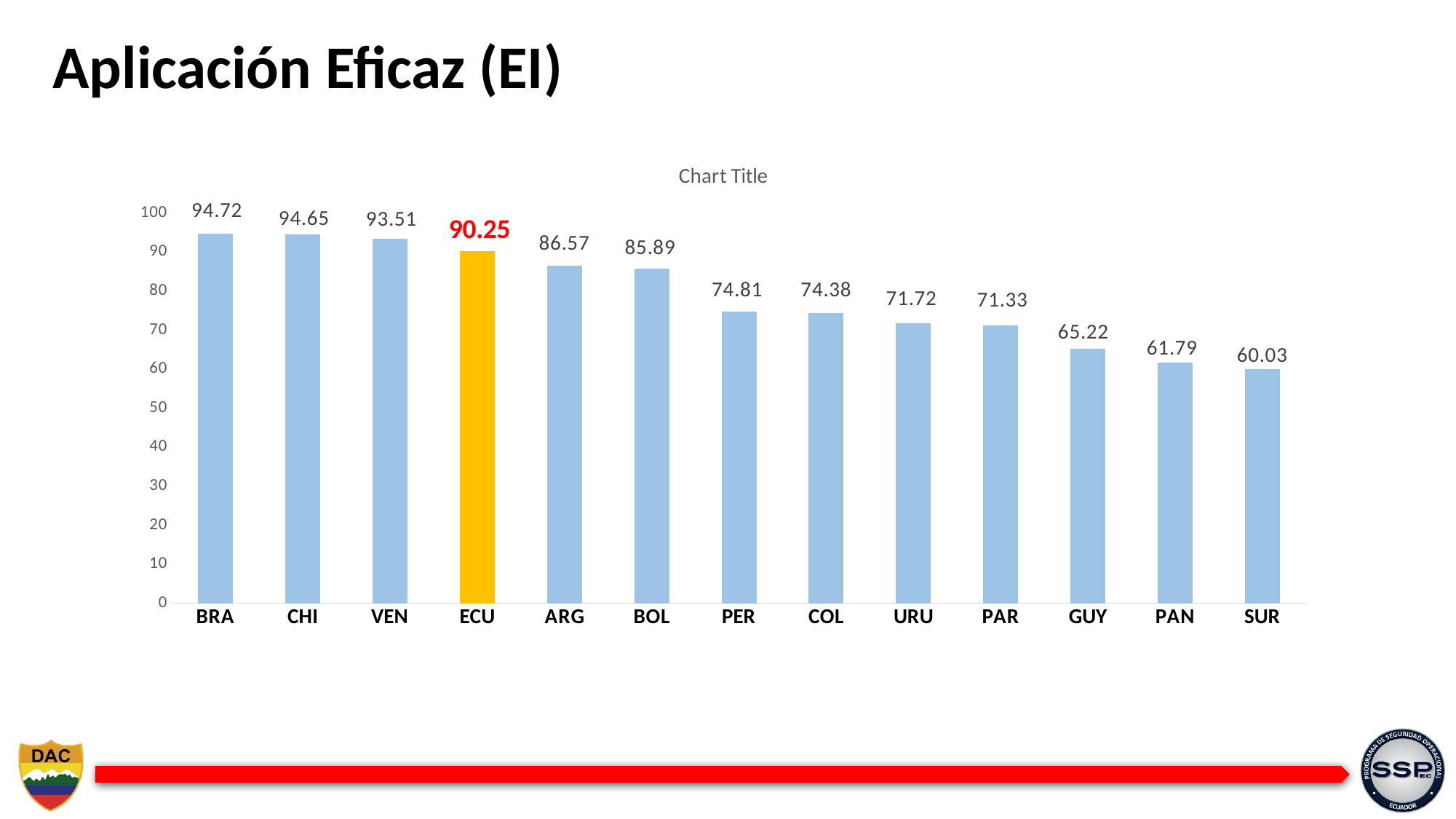
Is the value for URU greater or less than 70? greater What is the value for SUR? 60.03 Which bar is highlighted in a different colour (orange) from the others? ECU What is the value for PER? 74.81 Which is larger, the value for ARG or the value for BOL? ARG Which country has the lowest value? SUR Which country has the highest value? BRA What kind of chart is shown on the slide? Bar chart What is the difference between the values for GUY and PAN? 3.43 What is the value for ECU? 90.25 What is the difference between the values for BRA and ECU? 4.47 How many countries are shown on the x axis? 13